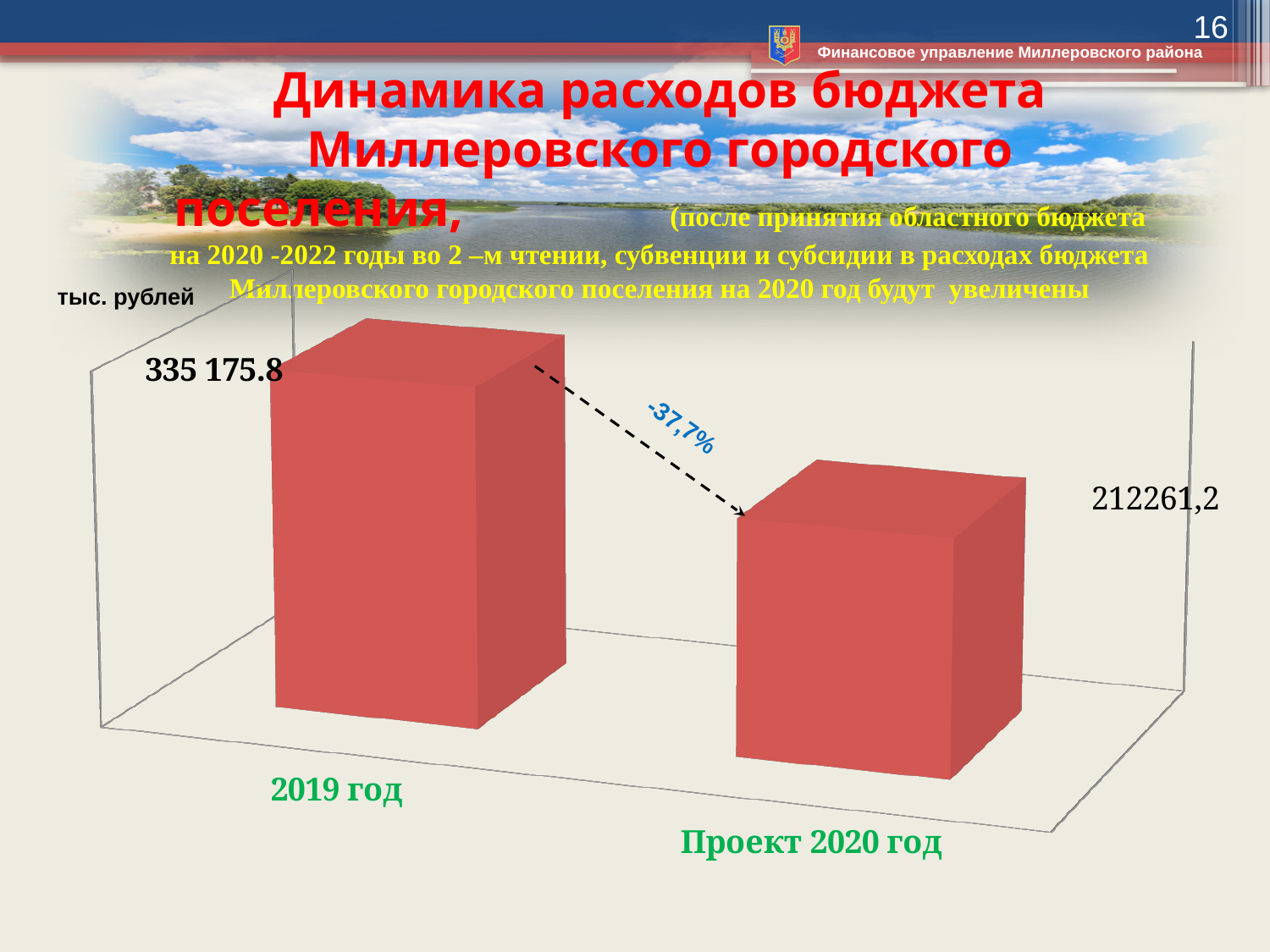
What is the value for Проект 2020 год? 212261,2 What kind of chart is shown on the slide? Bar chart Which is larger, the value for 2019 год or for Проект 2020 год? 2019 год How many categories are shown in the chart? 2 In what units are the chart values given? тыс. рублей What percentage change is shown by the arrow between the two bars? -37,7% Which category has the highest value? 2019 год Which category has the lowest value? Проект 2020 год What is the difference between the value for 2019 год and the value for Проект 2020 год? 122 914,6 Do the values rise or fall from 2019 год to Проект 2020 год? Fall What is the value for 2019 год? 335 175.8